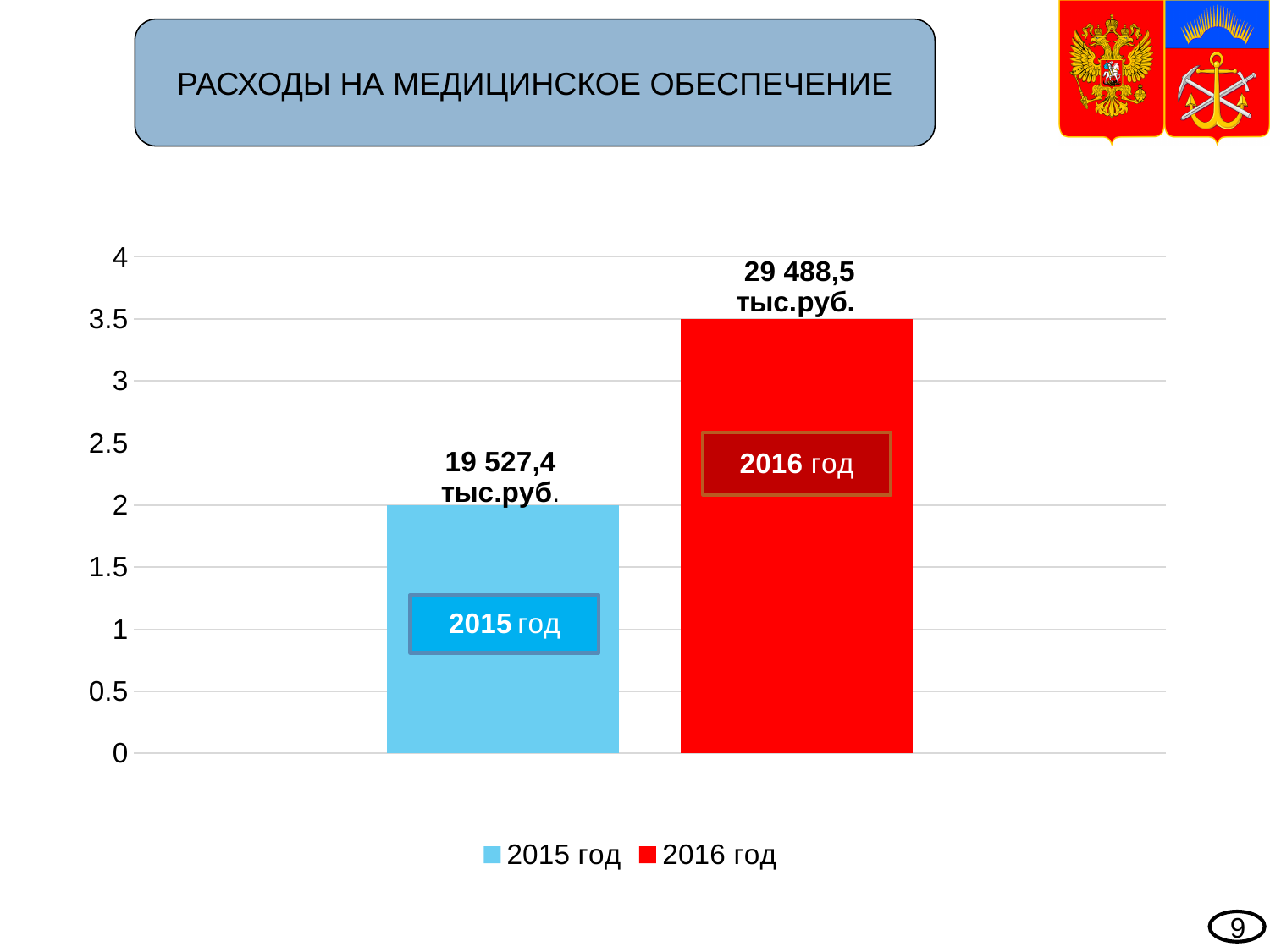
Which year has the lower labelled value? 2015 год What value is labelled on the bar for 2015 год? 19 527,4 тыс.руб. What is the title of the slide above the chart? РАСХОДЫ НА МЕДИЦИНСКОЕ ОБЕСПЕЧЕНИЕ How many bars are plotted on the chart? 2 Is the labelled value for 2016 год larger or smaller than the labelled value for 2015 год? larger What colour is the bar for 2016 год? red How many series does the legend list? 2 What value is labelled on the bar for 2016 год? 29 488,5 тыс.руб. What is the difference between the labelled values for 2016 год and 2015 год? 9 961,1 тыс.руб. Which year has the higher labelled value? 2016 год Do the values rise or fall from 2015 год to 2016 год? rise What kind of chart is shown on the slide? bar chart